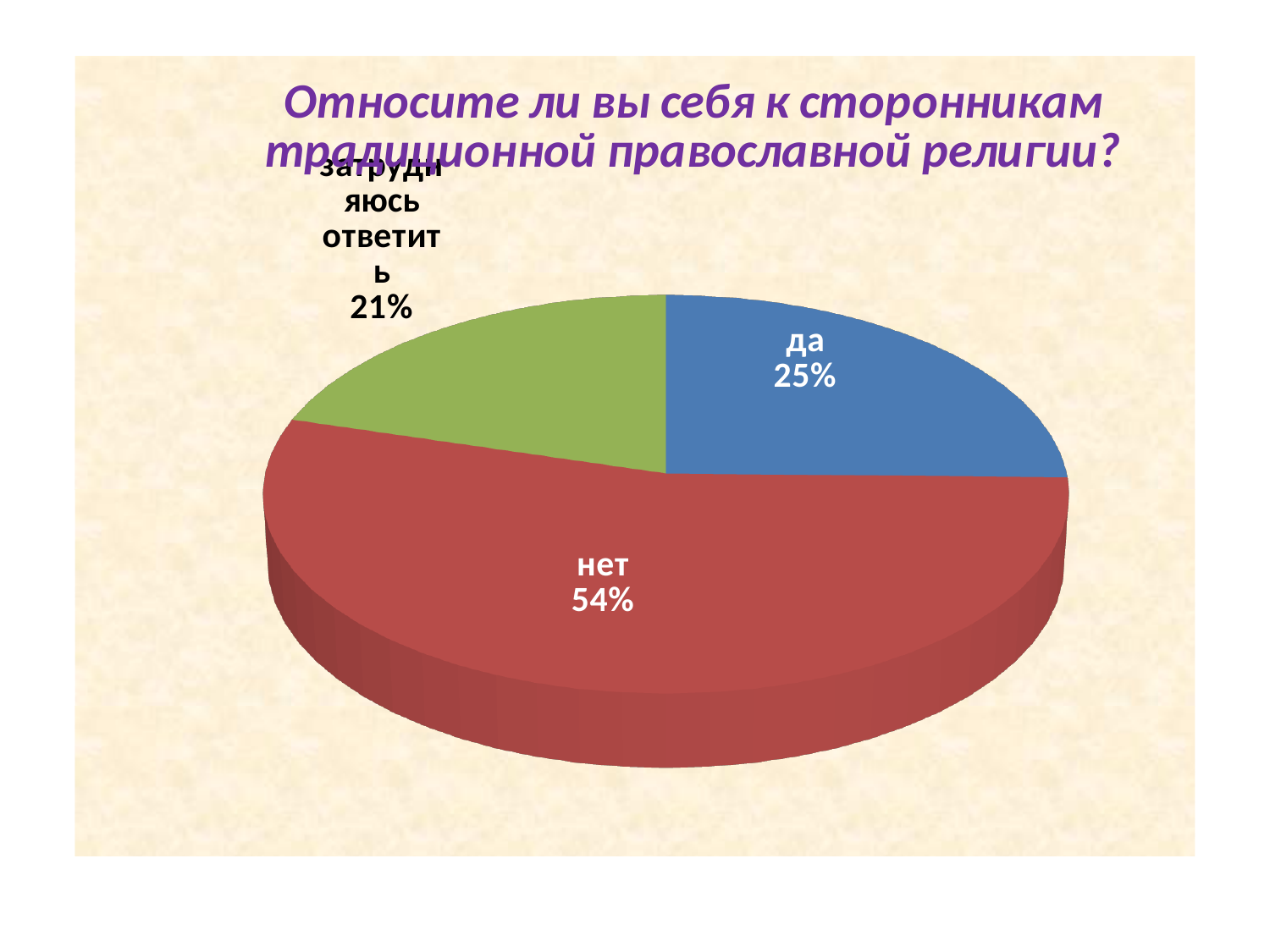
What kind of chart is shown on the slide? pie chart What is the difference in percentage points between "да" and "затрудняюсь ответить"? 4 What share of respondents answered "нет"? 54% What is the difference in percentage points between "нет" and "да"? 29 What share of respondents answered "затрудняюсь ответить"? 21% What colour is the slice for "нет"? red How many slices does the pie chart have? 3 What is the title of the chart? Относите ли вы себя к сторонникам традиционной православной религии? Which answer has the smallest share of the pie? затрудняюсь ответить Which is larger, the share for "да" or the share for "затрудняюсь ответить"? да Which answer has the largest share of the pie? нет What share of respondents answered "да"? 25%